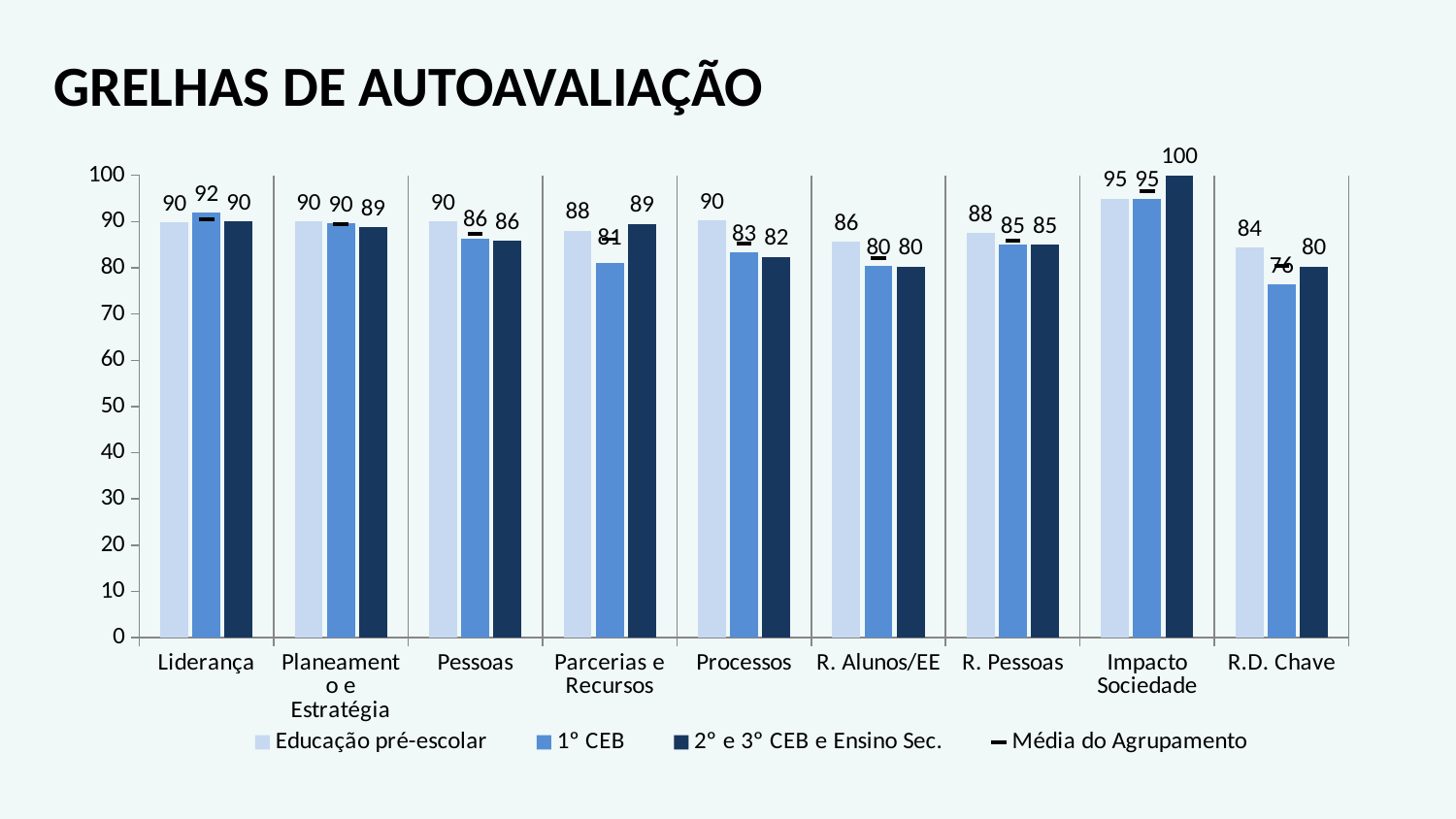
What is the difference between the Educação pré-escolar value and the 1° CEB value in the Processos category? 7 What is the title of the slide? GRELHAS DE AUTOAVALIAÇÃO Is the value for 1° CEB in the R. Alunos/EE category greater or less than 90? less Which category has the highest value for 2° e 3° CEB e Ensino Sec.? Impacto Sociedade How many categories are shown on the x axis? 9 What is the value for Educação pré-escolar in the Liderança category? 90 What is the value for 2° e 3° CEB e Ensino Sec. in the Impacto Sociedade category? 100 In the Pessoas category, which is larger: the Educação pré-escolar value or the 1° CEB value? Educação pré-escolar What kind of chart is shown on the slide? bar chart What is the value for 1° CEB in the Parcerias e Recursos category? 81 How many series does the legend list? 4 Which category has the lowest value for Educação pré-escolar? R.D. Chave